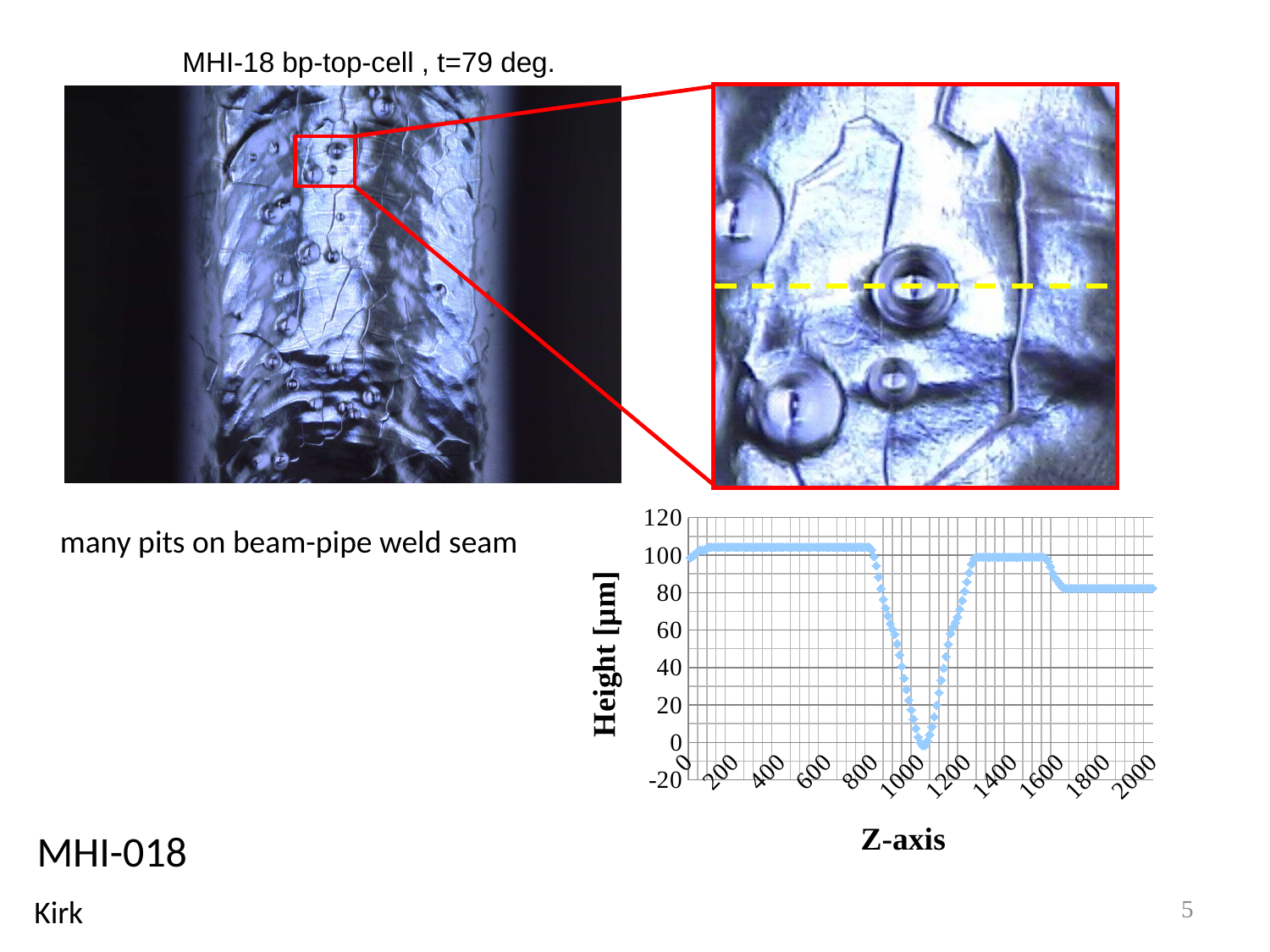
Is the height at Z = 1800 greater or less than 100? less Which is larger, the height at Z = 1000 or the height at Z = 1400? Z = 1400 Is the lowest height plotted on the chart greater or less than 20? less Which is larger, the height at Z = 400 or the height at Z = 1800? Z = 400 Is the height at Z = 1400 greater or less than 80? greater Does the height rise or fall as Z goes from 1100 to 1300? rise Does the height rise or fall as Z goes from 800 to 1000? fall What kind of chart is shown at the bottom right of the slide? scatter chart What is the label of the vertical axis of the chart? Height [µm] What is the label of the horizontal axis of the chart? Z-axis